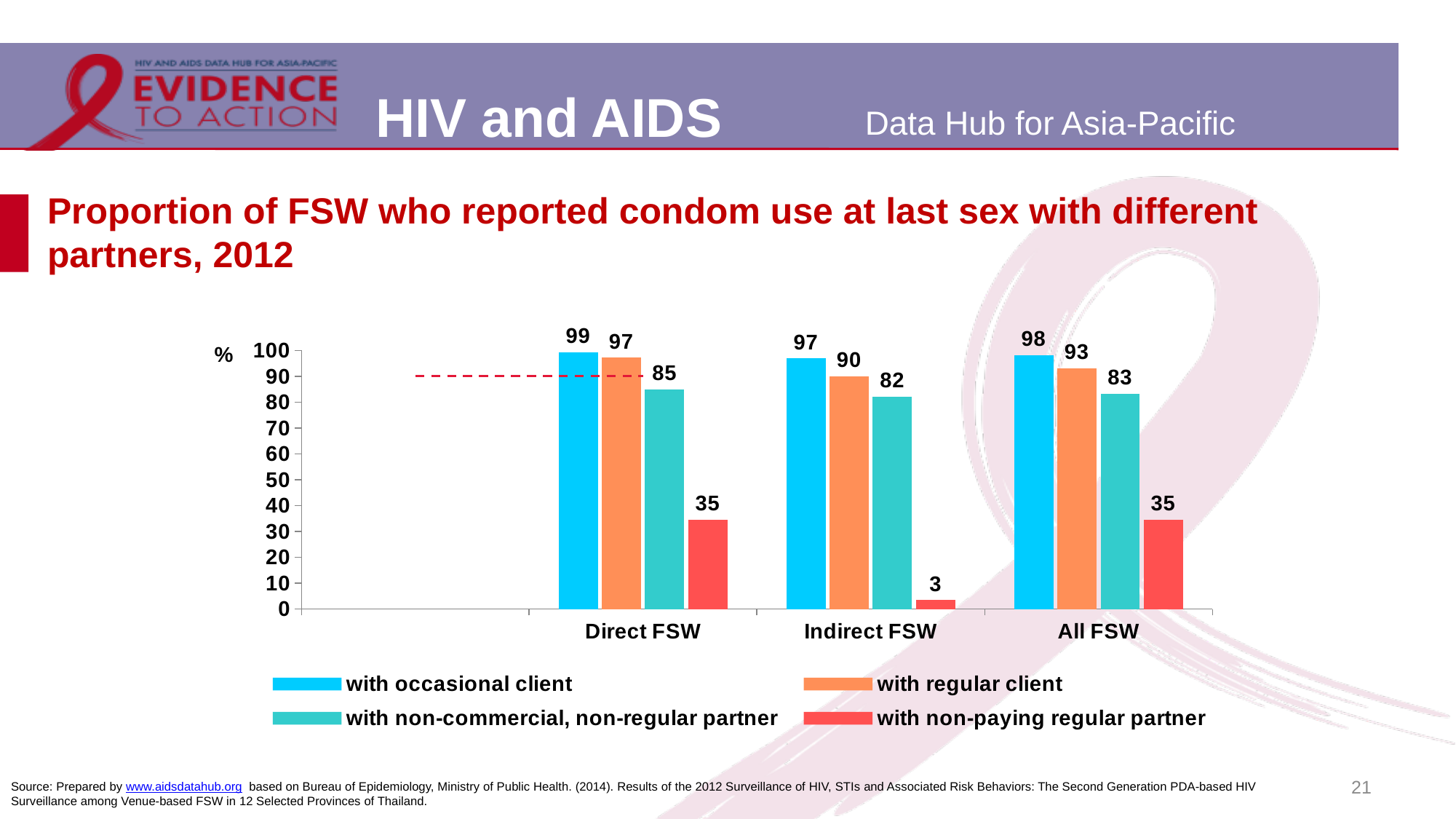
What is the value for Indirect FSW with non-commercial, non-regular partner? 82 How many FSW groups are shown on the x axis? 3 Which FSW group has the highest value with occasional client? Direct FSW What is the value for All FSW with regular client? 93 Which is larger: the Direct FSW value with regular client or the Indirect FSW value with regular client? Direct FSW What is the value for Direct FSW with occasional client? 99 Which partner type has the lowest value for Direct FSW? with non-paying regular partner What is the difference between the Direct FSW and Indirect FSW values with non-paying regular partner? 32 What is the value for Indirect FSW with non-paying regular partner? 3 What kind of chart is shown on the slide? bar chart What colour are the bars for 'with non-paying regular partner'? red How many series does the legend list? 4